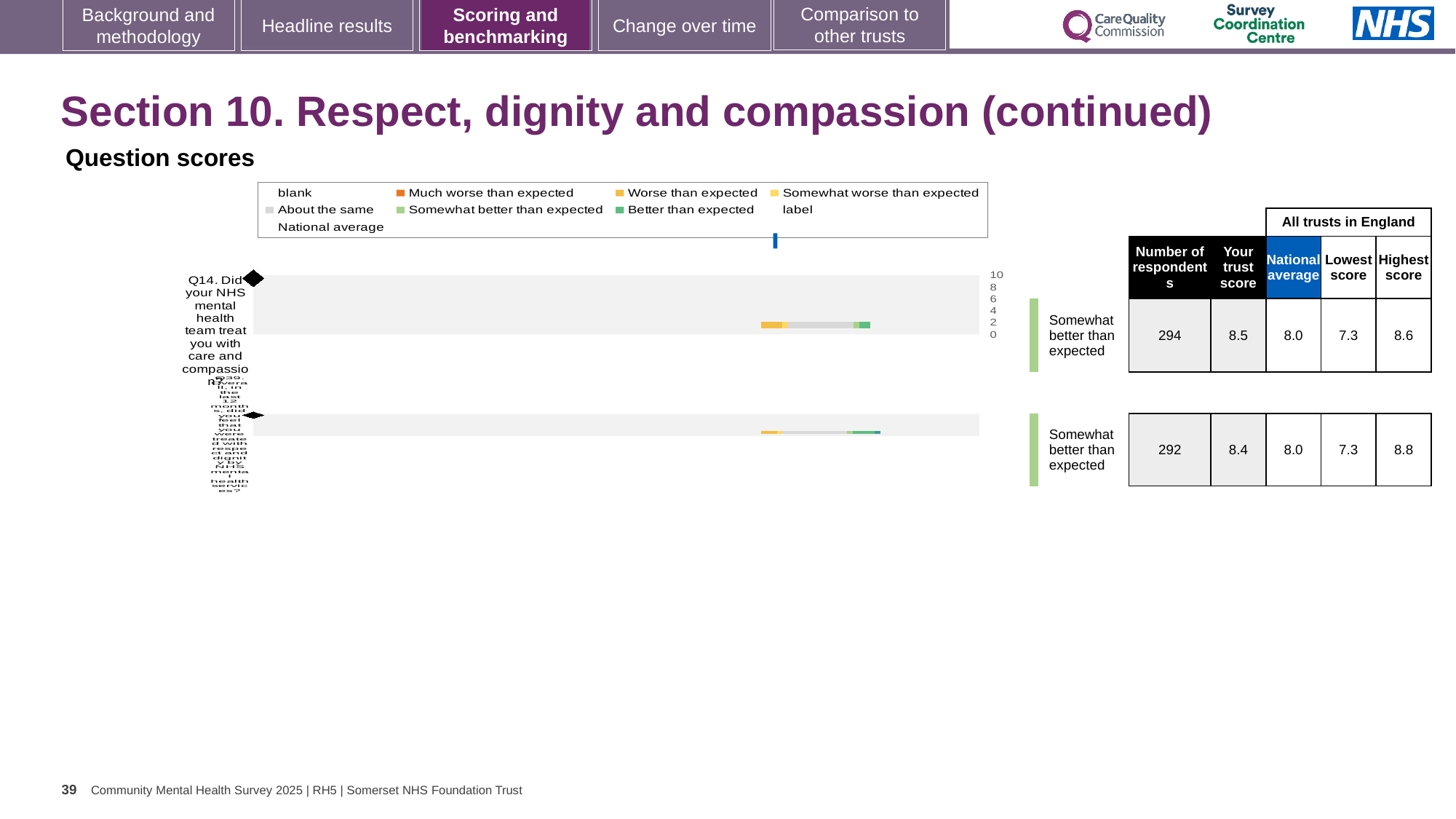
Which question had more respondents, Q14 or the second question shown (Q39)? Q14 What is the trust score for Q14 (Did your NHS mental health team treat you with care and compassion?)? 8.5 What is the trust score for the second question shown (Q39)? 8.4 What is the highest score among all trusts in England for the second question shown (Q39)? 8.8 What is the highest score among all trusts in England for Q14? 8.6 What is the national average score for Q14? 8.0 What benchmark category is shown for Q14? Somewhat better than expected How many respondents answered Q14? 294 How many questions are plotted in the chart? 2 By how much does the trust score for Q14 exceed the national average for Q14? 0.5 What kind of chart is used to show the question scores? Bar chart What is the lowest score among all trusts in England for the second question shown (Q39)? 7.3